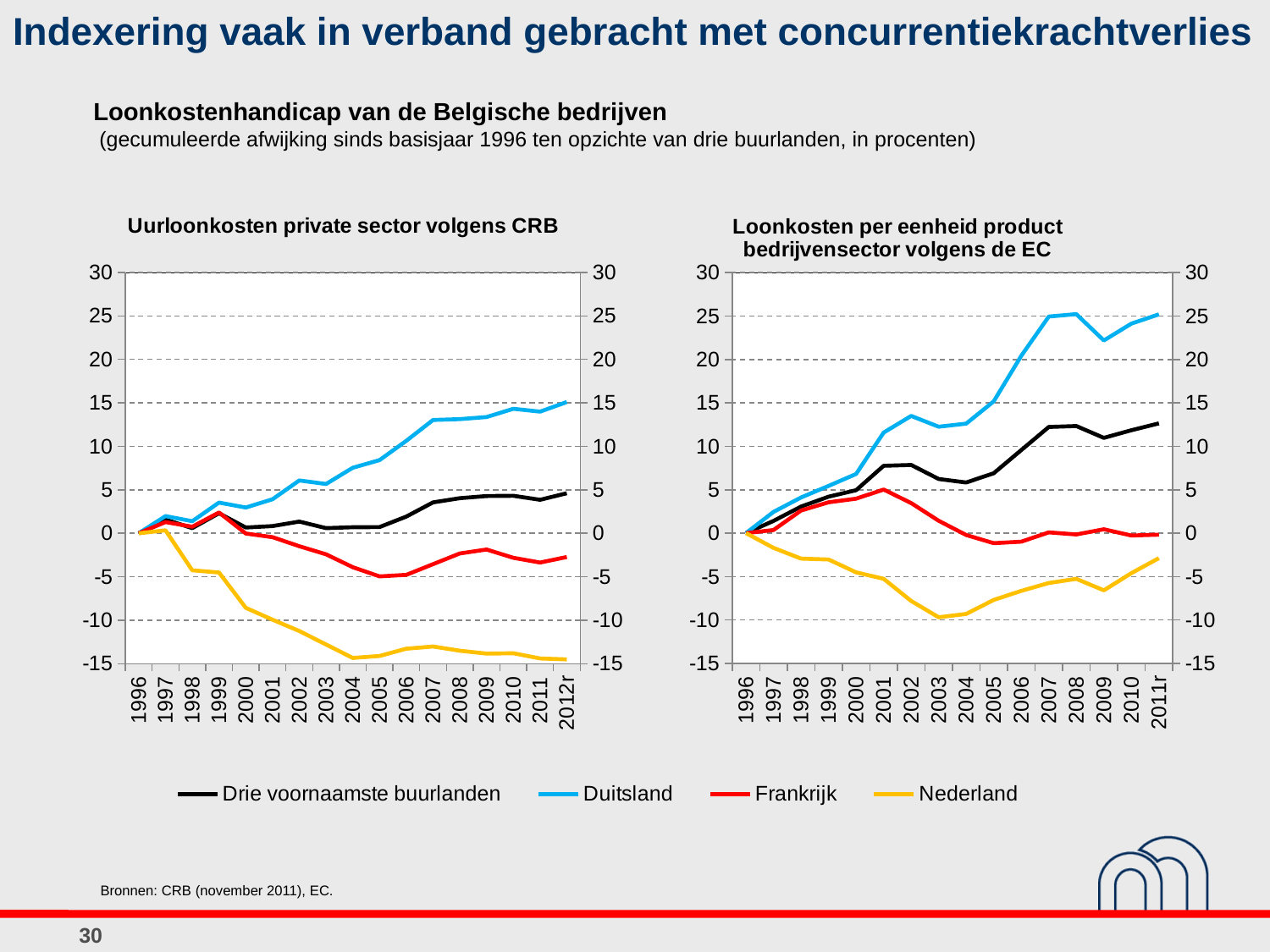
In the left chart, 'Uurloonkosten private sector volgens CRB', which series has the lowest value in 2012r? Nederland In the left chart, 'Uurloonkosten private sector volgens CRB', does the Duitsland line rise or fall from 1996 to 2012r? rise In the right chart, 'Loonkosten per eenheid product bedrijvensector volgens de EC', which series has the highest value in 2011r? Duitsland How many series does the legend list? 4 In the left chart, 'Uurloonkosten private sector volgens CRB', is the value for Duitsland in 2012r greater or less than 10? greater What kind of chart is the left chart, 'Uurloonkosten private sector volgens CRB'? line chart In the left chart, 'Uurloonkosten private sector volgens CRB', does the Nederland line rise or fall from 1996 to 2012r? fall In the right chart, 'Loonkosten per eenheid product bedrijvensector volgens de EC', is the value for Duitsland in 2011r greater or less than 20? greater How many years are shown on the x axis of the right chart, 'Loonkosten per eenheid product bedrijvensector volgens de EC'? 16 How many years are shown on the x axis of the left chart, 'Uurloonkosten private sector volgens CRB'? 17 In the right chart, 'Loonkosten per eenheid product bedrijvensector volgens de EC', is the value for Nederland in 2003 greater or less than -5? less